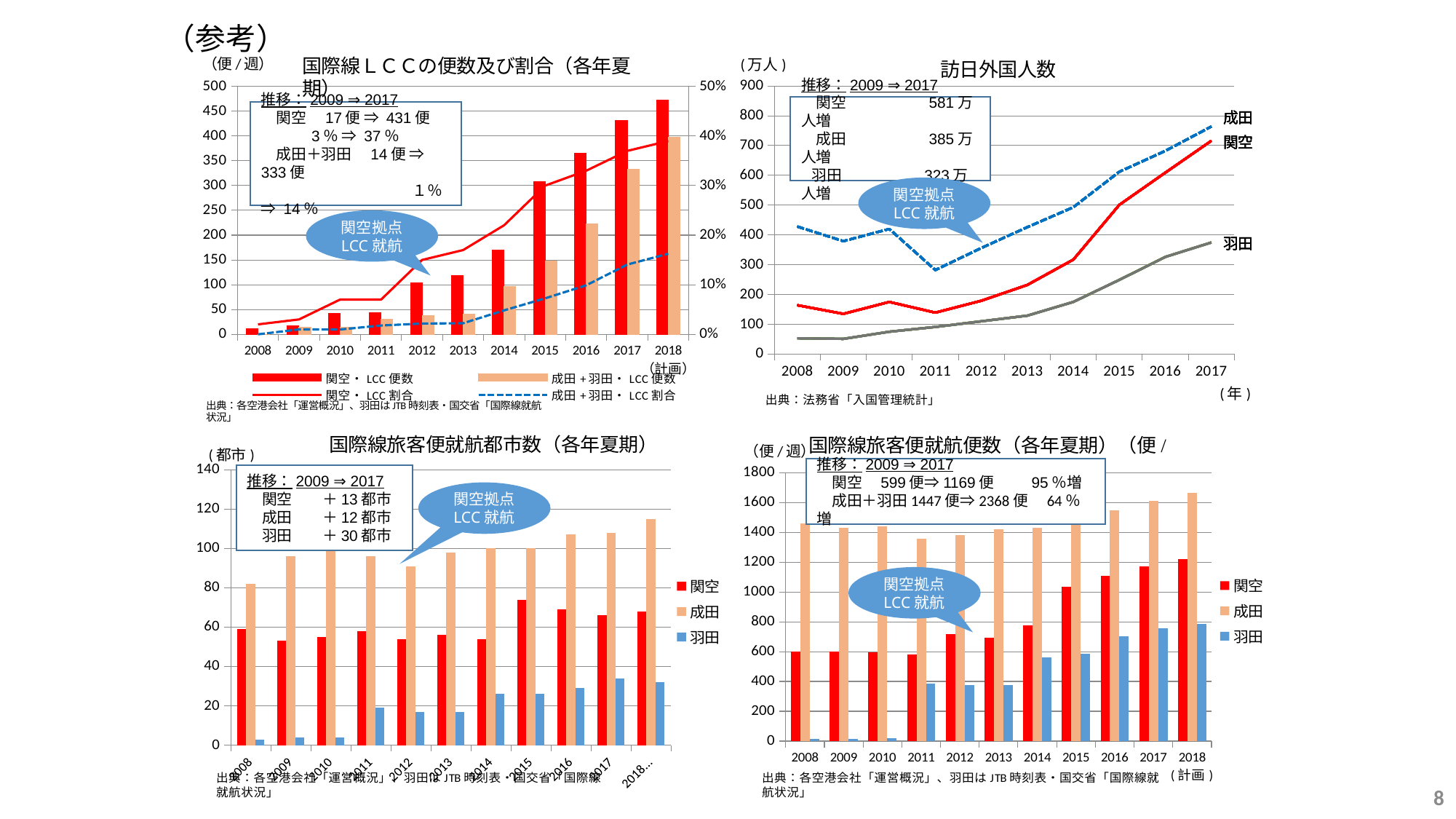
In the 訪日外国人数 chart (top right), is the value for 羽田 in 2008 greater or less than 100? less In the 訪日外国人数 chart (top right), is the value for 成田 in 2017 greater or less than 700? greater In the 国際線旅客便就航便数 chart (bottom right), is the value for 羽田 in 2018 greater or less than 600? greater In the 国際線LCCの便数及び割合 chart (top left), do the 関空・LCC便数 bars rise or fall from 2008 to 2018? rise How many years are shown on the x axis of the 訪日外国人数 chart (top right)? 10 In the 国際線旅客便就航都市数 chart (bottom left), which series has the highest value in 2018? 成田 What kind of chart is the 訪日外国人数 chart (top right)? line chart What unit is shown above the left axis of the 国際線LCCの便数及び割合 chart (top left)? 便/週 How many series does the legend of the 国際線旅客便就航都市数 chart (bottom left) list? 3 In the 国際線旅客便就航便数 chart (bottom right), which is larger in 2018, 成田 or 関空? 成田 In the 国際線旅客便就航都市数 chart (bottom left), which series has the lowest value in 2008? 羽田